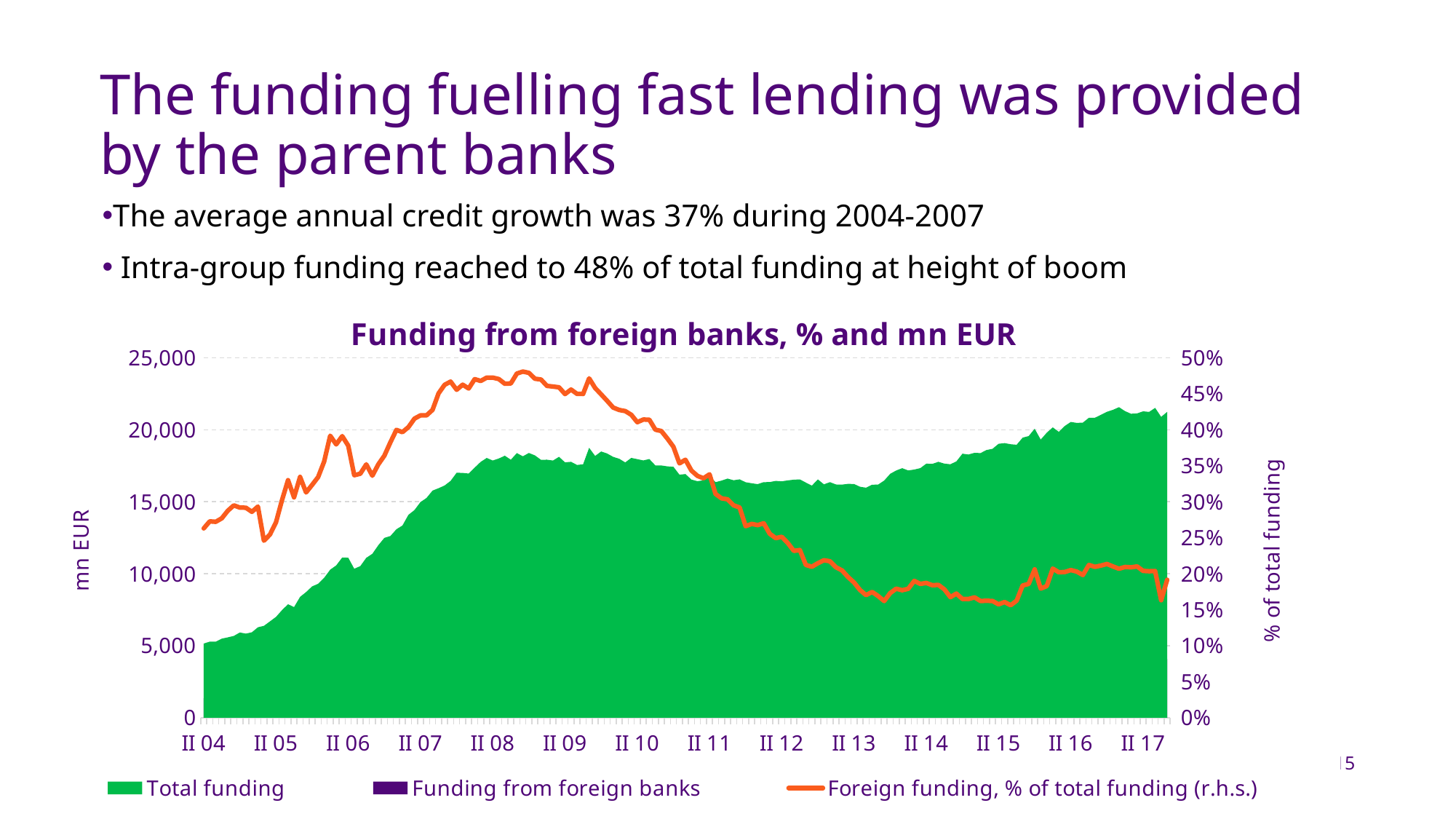
What kind of chart is shown on the slide? Area chart with a line Does Total funding rise or fall between II 04 and II 08? rise Is the value of Total funding at II 05 greater or less than 10,000? less How many period labels are shown on the x axis? 14 How many series does the chart legend list? 3 Is the value of Foreign funding, % of total funding at II 15 greater or less than 20%? less Is the value of Total funding at II 08 greater or less than 15,000? greater Does Foreign funding, % of total funding rise or fall between II 09 and II 15? fall Which series is plotted on the right-hand axis? Foreign funding, % of total funding (r.h.s.) What is the title of the chart? Funding from foreign banks, % and mn EUR